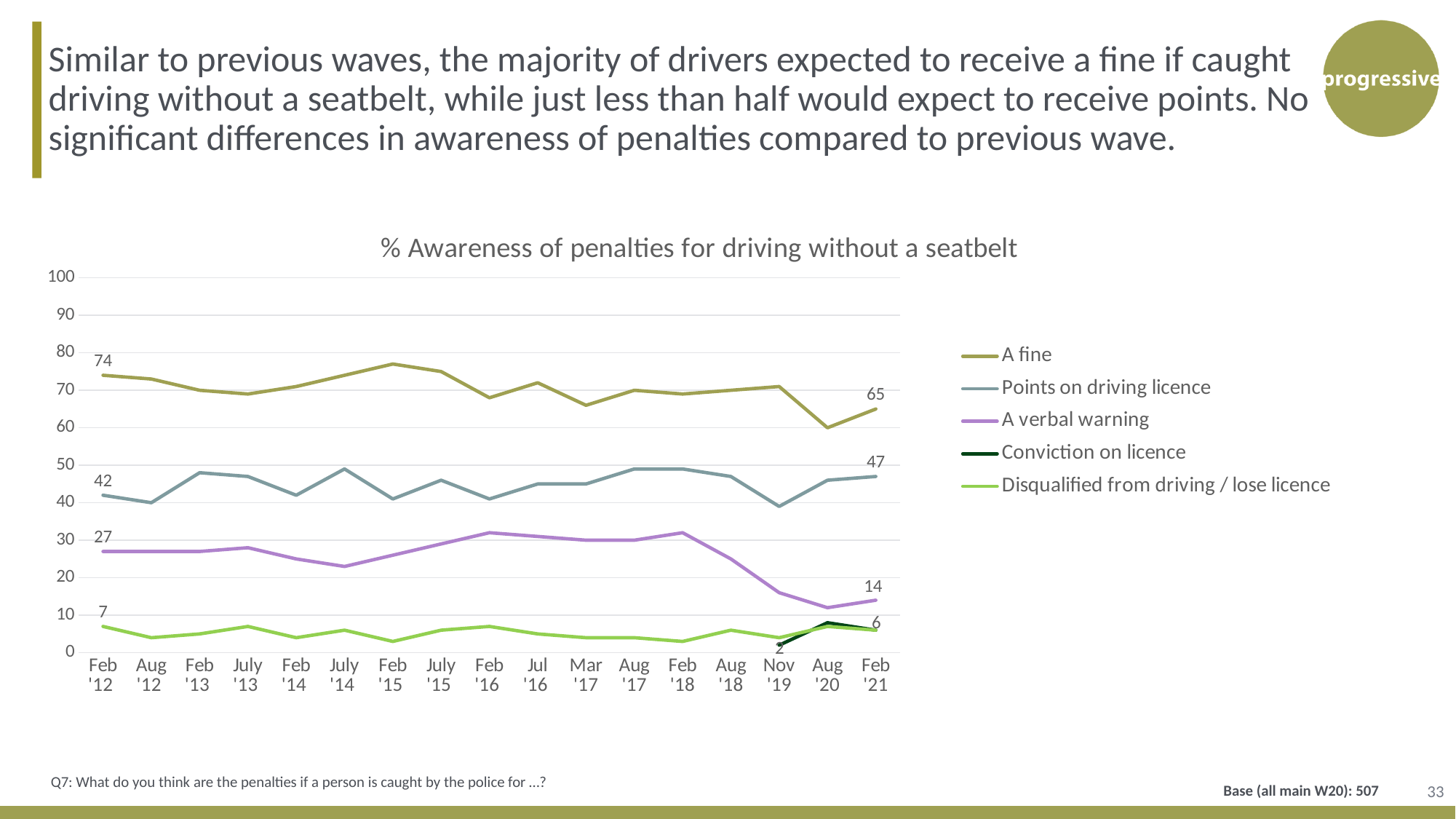
How many time points are shown on the x axis? 17 What is the value for 'A fine' in Feb '21? 65 What is the value for 'Conviction on licence' in Nov '19? 2 What is the title of the chart? % Awareness of penalties for driving without a seatbelt Which is larger in Feb '12: 'A verbal warning' or 'Disqualified from driving / lose licence'? A verbal warning What is the value for 'A verbal warning' in Feb '21? 14 Which series has the highest value in Feb '21? A fine What is the value for 'Points on driving licence' in Feb '12? 42 Is the value for 'A fine' in Aug '20 greater or less than 70? less How many series does the legend list? 5 What type of chart is shown on the slide? line chart By how much did the value for 'A fine' change from Feb '12 (74) to Feb '21 (65)? 9